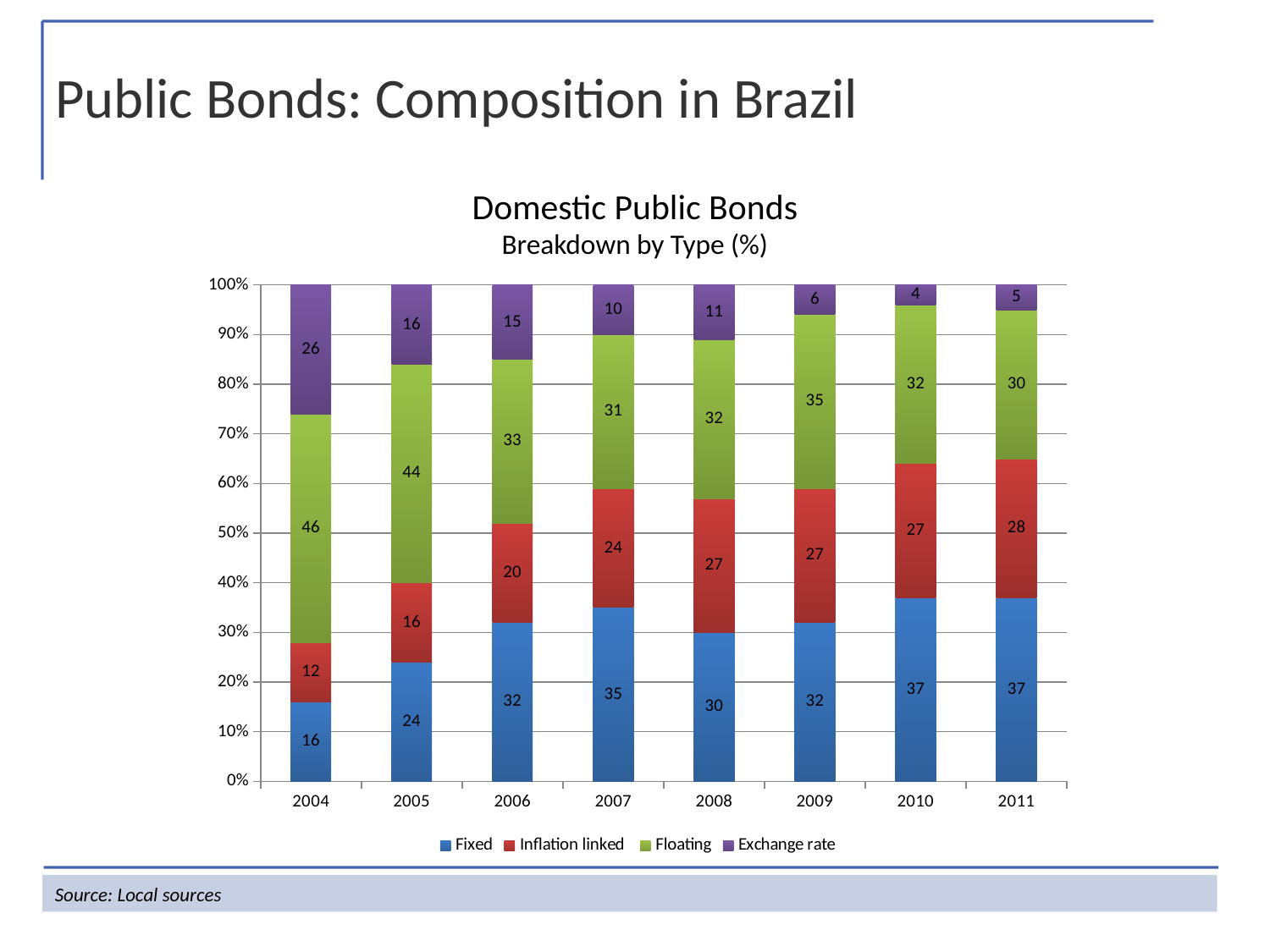
How many series does the legend list? 4 How many years are shown on the x axis? 8 What is the difference between the Floating values for 2004 and 2011? 16 Which is larger, the Inflation linked value for 2006 or for 2008? 2008 In which year is the Exchange rate value highest? 2004 What is the Fixed value for 2004? 16 What is the Inflation linked value for 2011? 28 Does the Exchange rate value rise or fall from 2004 to 2011? Fall What is the Exchange rate value for 2010? 4 What is the Floating value for 2005? 44 What kind of chart is shown? Stacked bar chart In which year is the Fixed value lowest? 2004